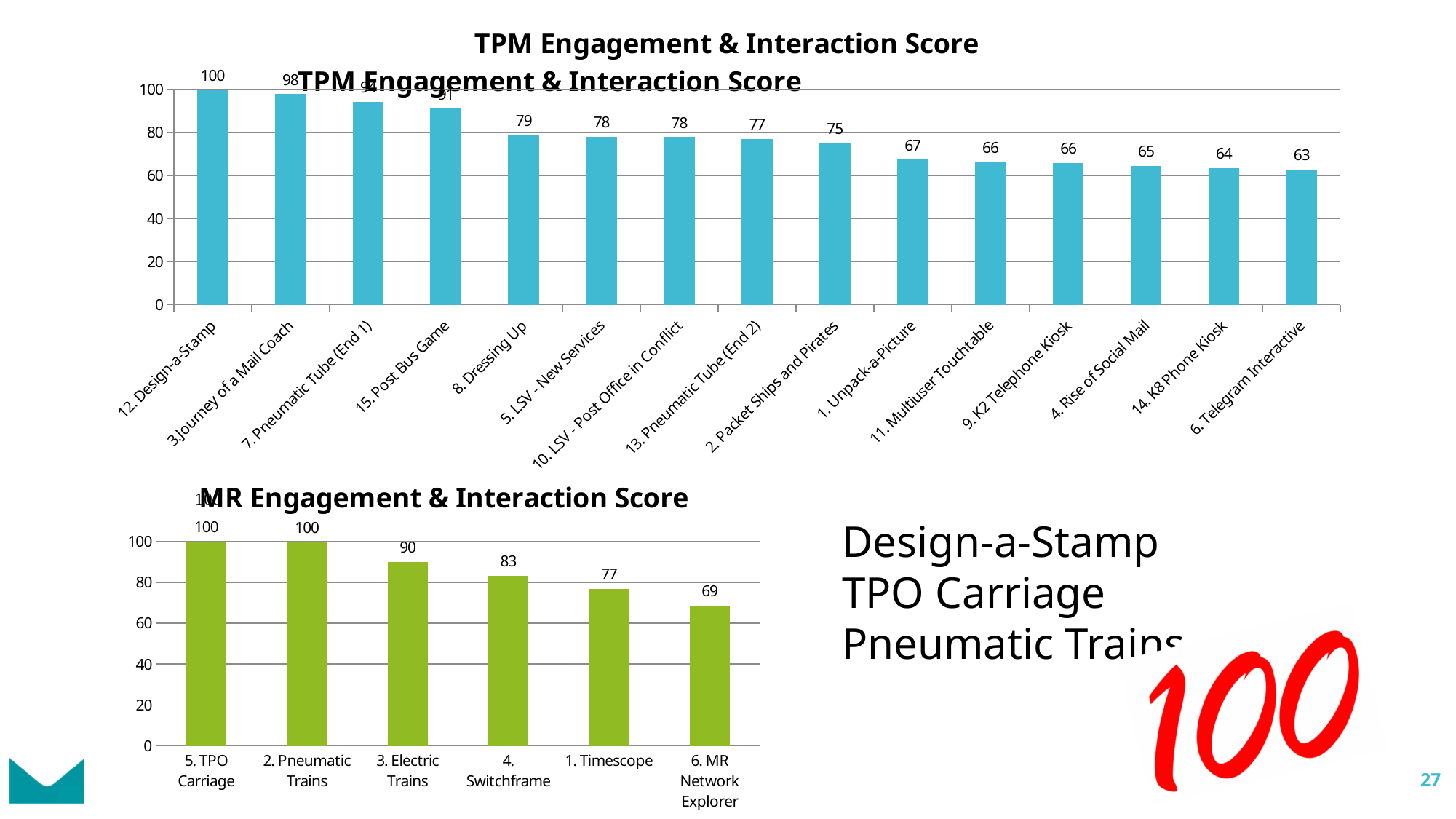
In the TPM Engagement & Interaction Score chart, which category has the highest score? 12. Design-a-Stamp What type of chart is the MR Engagement & Interaction Score chart? bar chart In the TPM Engagement & Interaction Score chart, which category has the lowest score? 6. Telegram Interactive In the TPM Engagement & Interaction Score chart, is the score for 1. Unpack-a-Picture greater or less than 80? less In the TPM Engagement & Interaction Score chart, what is the difference between the scores for 12. Design-a-Stamp and 2. Packet Ships and Pirates? 25 In the TPM Engagement & Interaction Score chart, what is the score for 6. Telegram Interactive? 63 In the MR Engagement & Interaction Score chart, what is the score for 3. Electric Trains? 90 In the MR Engagement & Interaction Score chart, how many categories are plotted? 6 In the TPM Engagement & Interaction Score chart, what is the score for 8. Dressing Up? 79 In the TPM Engagement & Interaction Score chart, how many categories are plotted? 15 In the MR Engagement & Interaction Score chart, what is the difference between the scores for 4. Switchframe and 1. Timescope? 6 In the MR Engagement & Interaction Score chart, which category has the lowest score? 6. MR Network Explorer